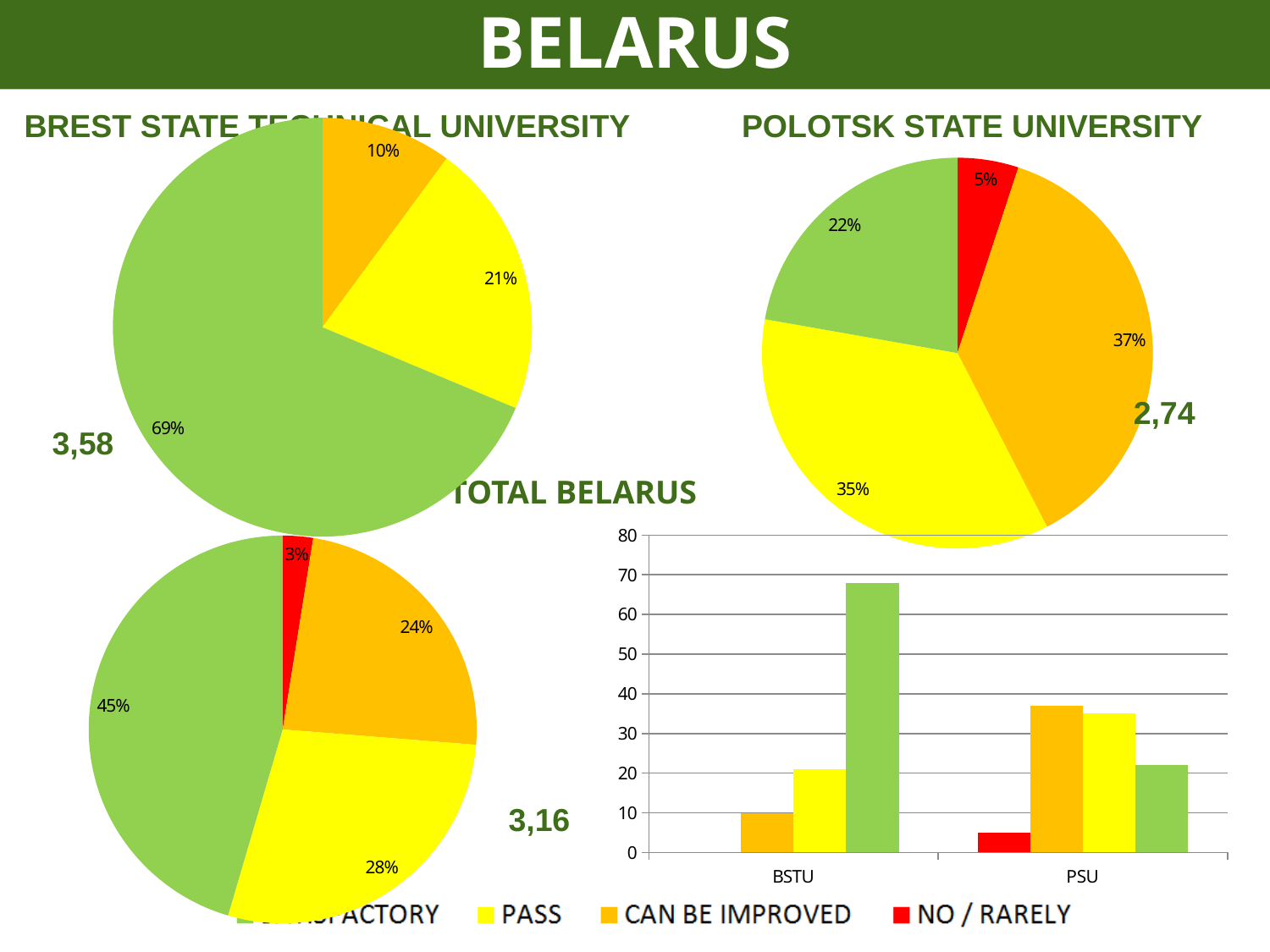
How many slices does the Brest State Technical University pie chart have? 3 In the Polotsk State University pie chart, which is larger: the yellow (PASS) slice or the green (SATISFACTORY) slice? PASS (35%) How many categories are shown on the x axis of the bar chart at the bottom right? 2 In the Total Belarus pie chart, what is the difference between the green (45%) slice and the yellow (28%) slice? 17% In the bar chart at the bottom right, is the red bar for PSU greater or less than 10? less In the bar chart at the bottom right, is the green bar for BSTU greater or less than 60? greater In the Brest State Technical University pie chart, what percentage is shown for the largest (green) slice? 69% What kind of chart is the Total Belarus chart on the bottom right of the slide? Bar chart In the Total Belarus pie chart, what percentage is shown for the red (NO / RARELY) slice? 3% In the Polotsk State University pie chart, which slice is the smallest? NO / RARELY (5%) In the Polotsk State University pie chart, what percentage is shown for the orange (CAN BE IMPROVED) slice? 37% In the Brest State Technical University pie chart, what percentage is shown for the yellow (PASS) slice? 21%